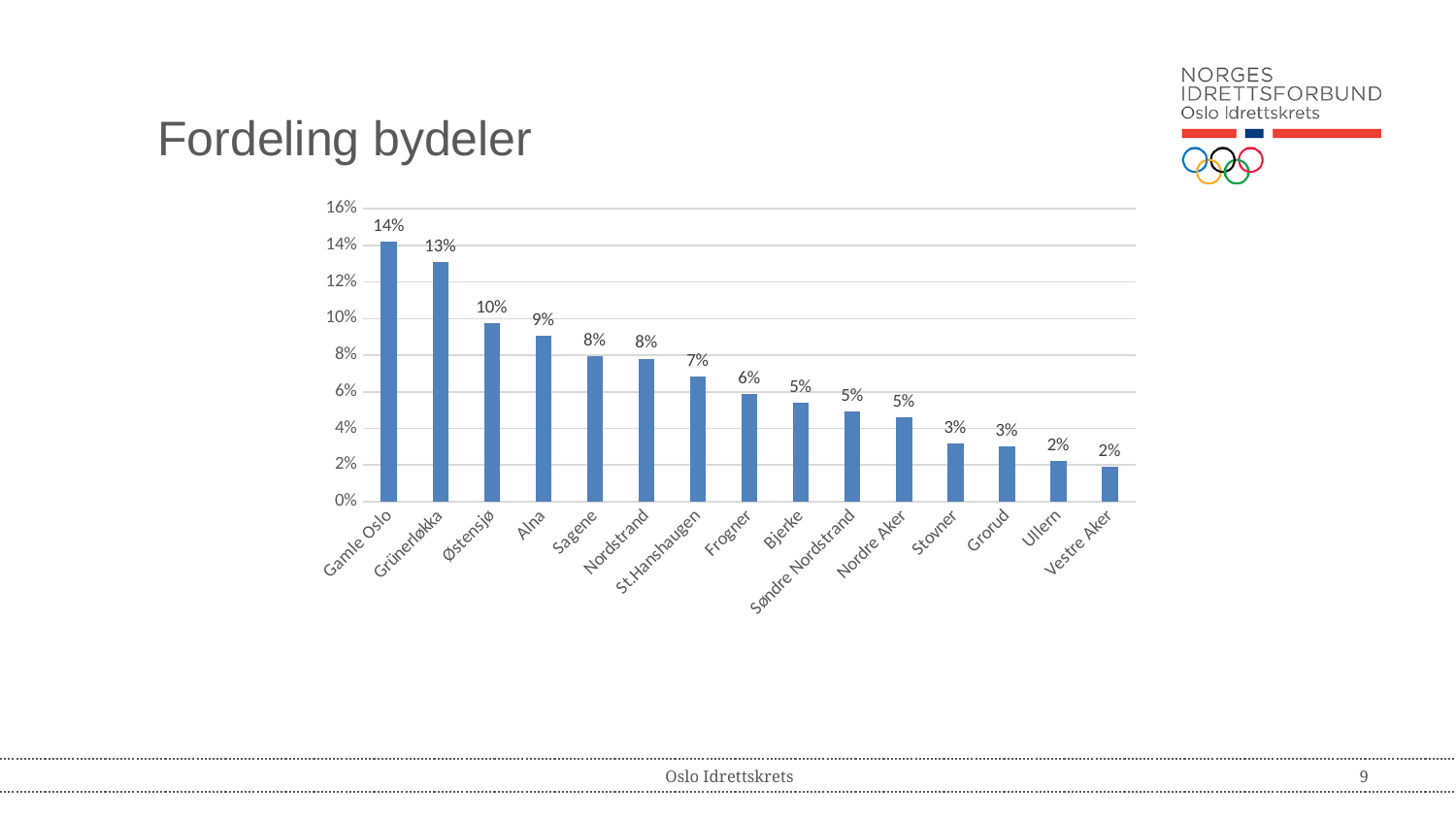
What is the difference between the values for Østensjø and Frogner? 4% Is the value for Frogner greater or less than 4%? greater What is the value for Østensjø? 10% How many bydeler are shown on the x axis? 15 What is the value for St.Hanshaugen? 7% Which is larger, the value for Østensjø or the value for Alna? Østensjø What is the difference between the values for Gamle Oslo and Grünerløkka? 1% What is the value for Gamle Oslo? 14% What is the value for Stovner? 3% What kind of chart is shown on the slide? bar chart Which bydel has the highest value? Gamle Oslo Do the values rise or fall from left to right along the x axis? fall